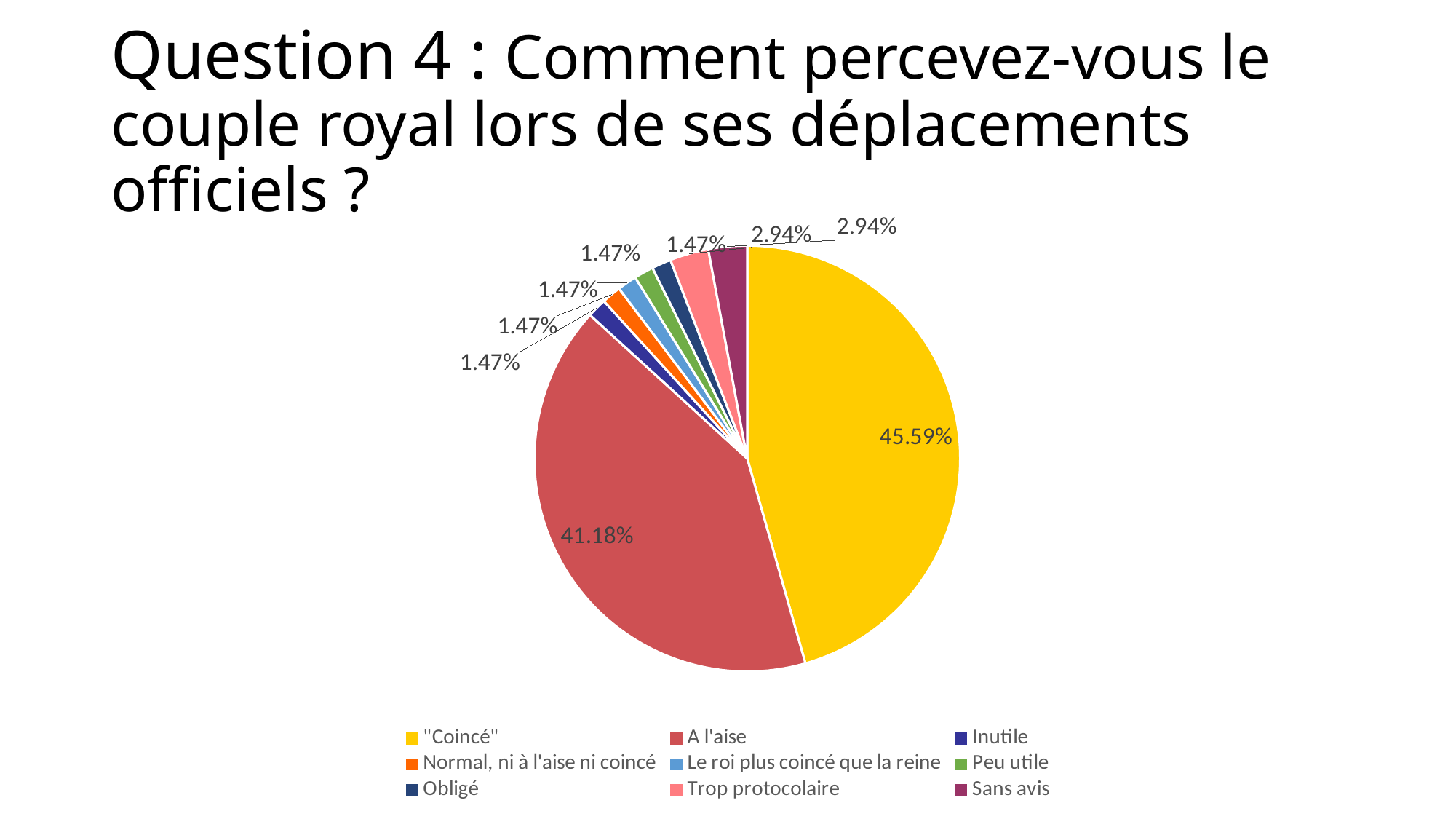
What is the smallest percentage value shown on the pie chart? 1.47% What percentage is shown for Trop protocolaire? 2.94% How many categories are listed in the legend of the pie chart? 9 What share of the pie does "Coincé" represent? 45.59% What share of the pie does A l'aise represent? 41.18% What percentage is shown for Obligé? 1.47% Which category has the largest slice of the pie? "Coincé" What colour is the slice for "Coincé"? yellow What type of chart is shown on the slide? pie chart What percentage is shown for Sans avis? 2.94% Which is larger, the share for "Coincé" or the share for A l'aise? "Coincé" What is the difference in percentage points between "Coincé" and A l'aise? 4.41%